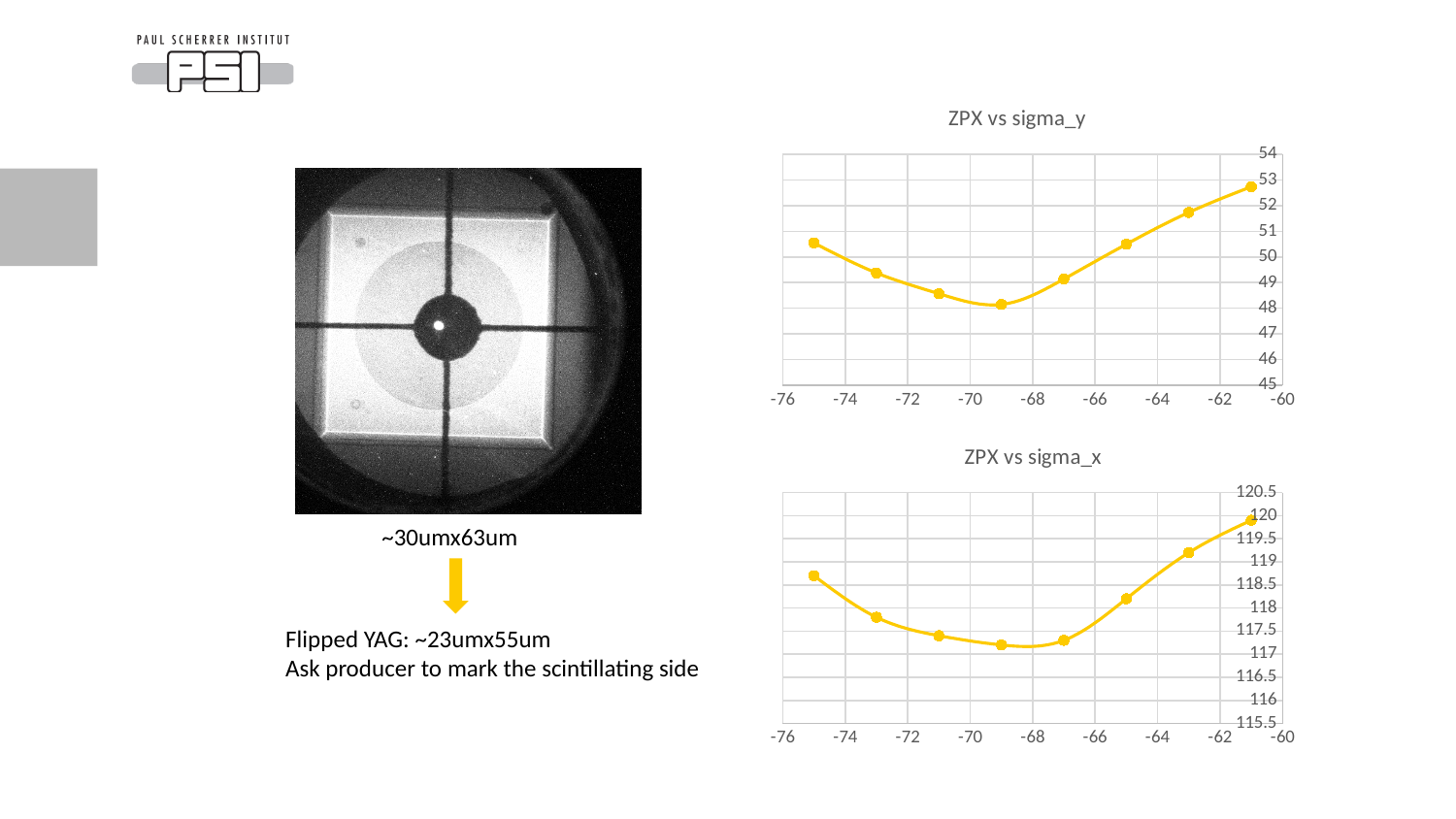
How many data points are plotted on the 'ZPX vs sigma_y' chart? 8 On the 'ZPX vs sigma_x' chart, is the value at x = -71 greater or less than 118? less How many data points are plotted on the 'ZPX vs sigma_x' chart? 8 On the 'ZPX vs sigma_y' chart, which is larger: the value at x = -63 or the value at x = -73? -63 On the 'ZPX vs sigma_y' chart, at which x value is the plotted value highest? -61 On the 'ZPX vs sigma_x' chart, is the value at x = -61 greater or less than 119.5? greater What colour is the line on the 'ZPX vs sigma_x' chart? yellow On the 'ZPX vs sigma_y' chart, is the value at x = -75 greater or less than 50? greater On the 'ZPX vs sigma_x' chart, at which x value is the plotted value lowest? -69 On the 'ZPX vs sigma_y' chart, at which x value is the plotted value lowest? -69 What kind of chart is the 'ZPX vs sigma_y' chart? line chart